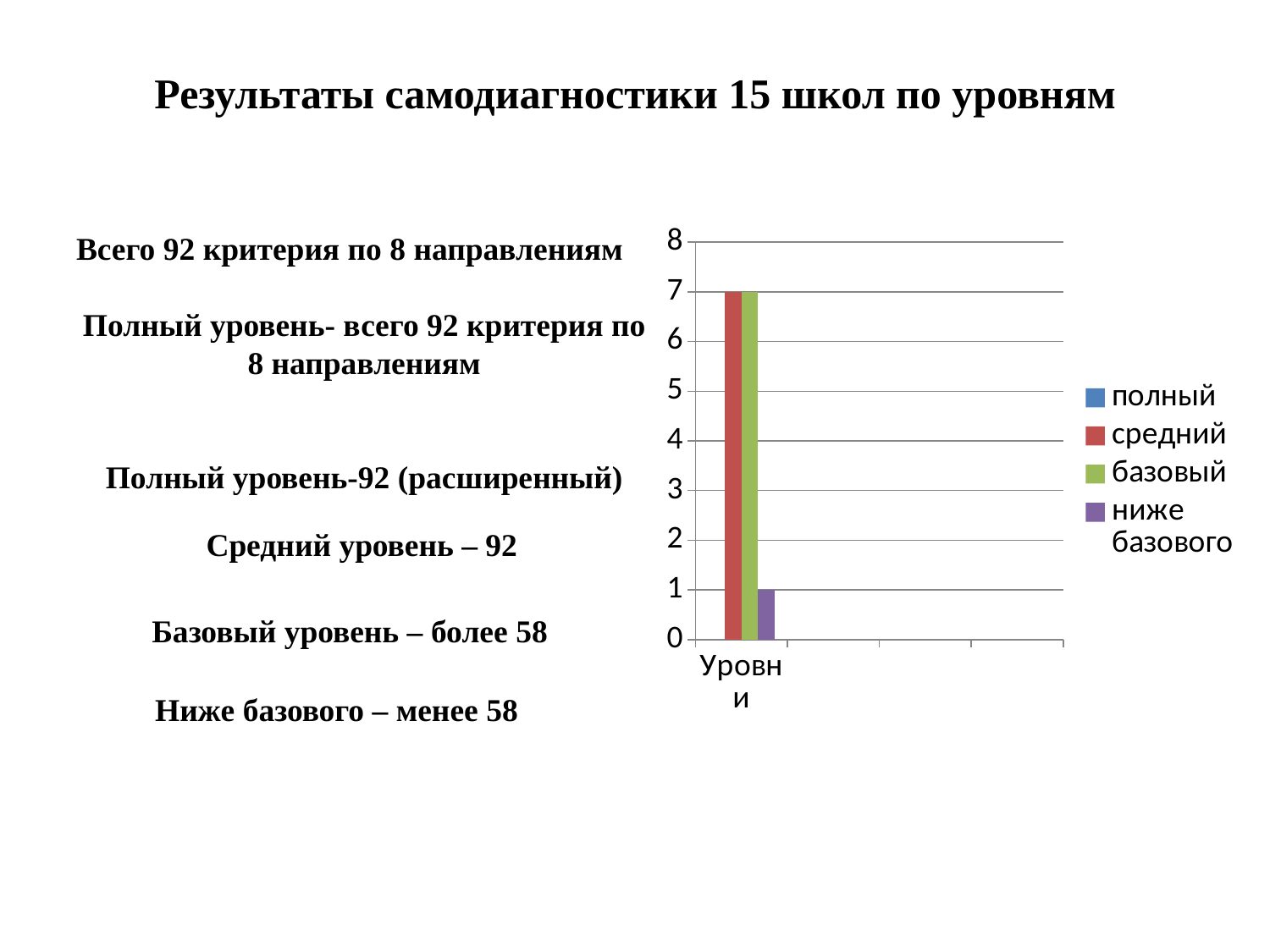
How many series does the chart legend list? 4 What kind of chart is shown on the slide? bar chart Is the value for 'ниже базового' greater or less than 4? less What is the label of the category on the x axis? Уровни Which is larger for 'Уровни': the 'средний' value or the 'ниже базового' value? средний Which series is shown in red in the legend? средний How many categories are shown on the x axis of the chart? 1 What is the value of the 'базовый' series for 'Уровни'? 7 Is the value for 'средний' greater or less than 5? greater What is the value of the 'ниже базового' series for 'Уровни'? 1 What is the difference between the 'базовый' value and the 'ниже базового' value? 6 What is the value of the 'средний' series for 'Уровни'? 7